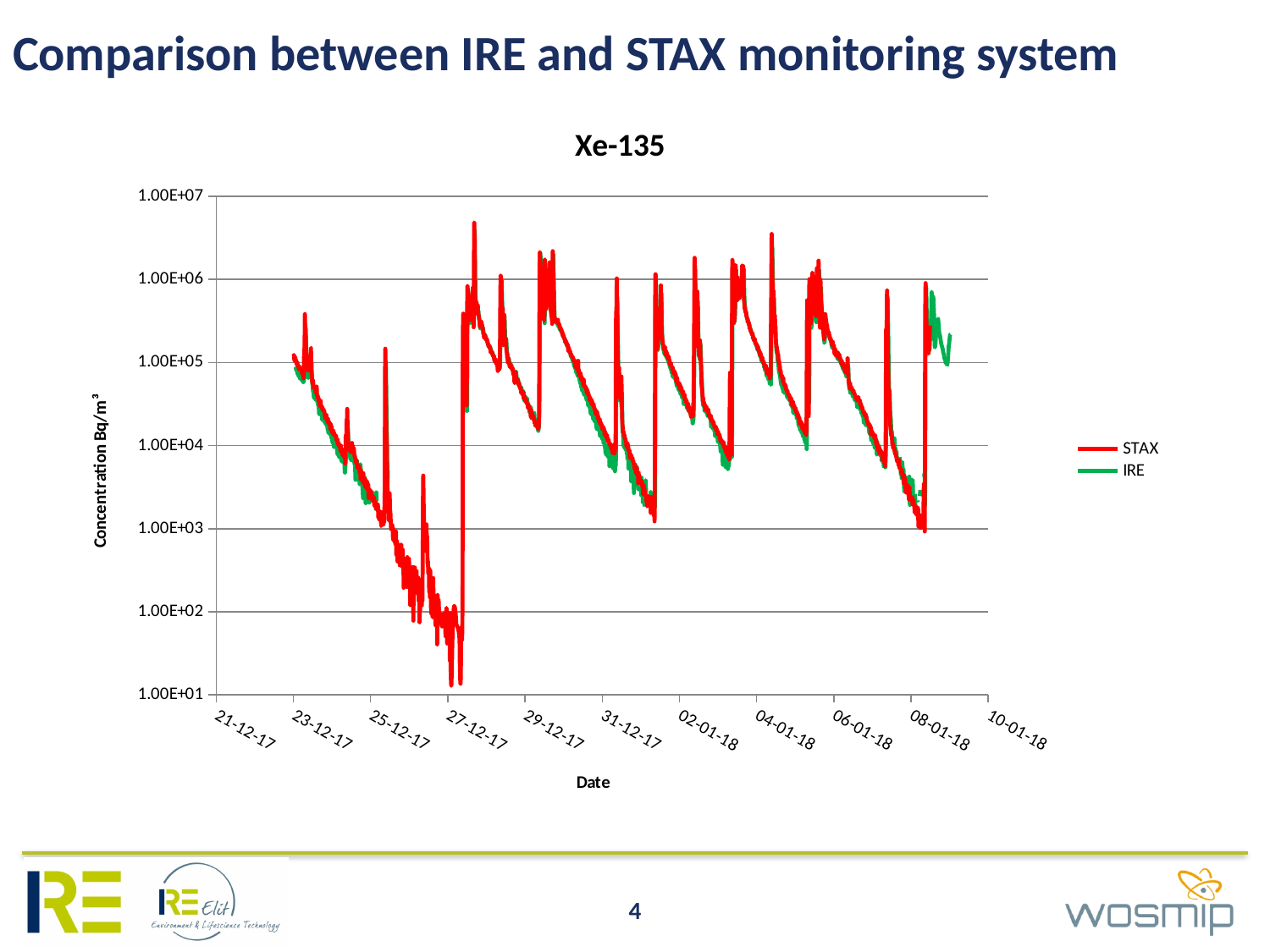
What is the lowest value shown on the y axis? 1.00E+01 What is the label of the y axis? Concentration Bq/m³ Is the STAX value at the start of the series, around 23-12-17, greater or less than 1.00E+04? greater Is the highest STAX peak, just after 27-12-17, greater or less than 1.00E+06? greater How many series does the legend list? 2 What is the label of the x axis? Date What kind of chart is shown on the slide? Line chart Is the lowest STAX value, reached shortly before 27-12-17, greater or less than 1.00E+02? less